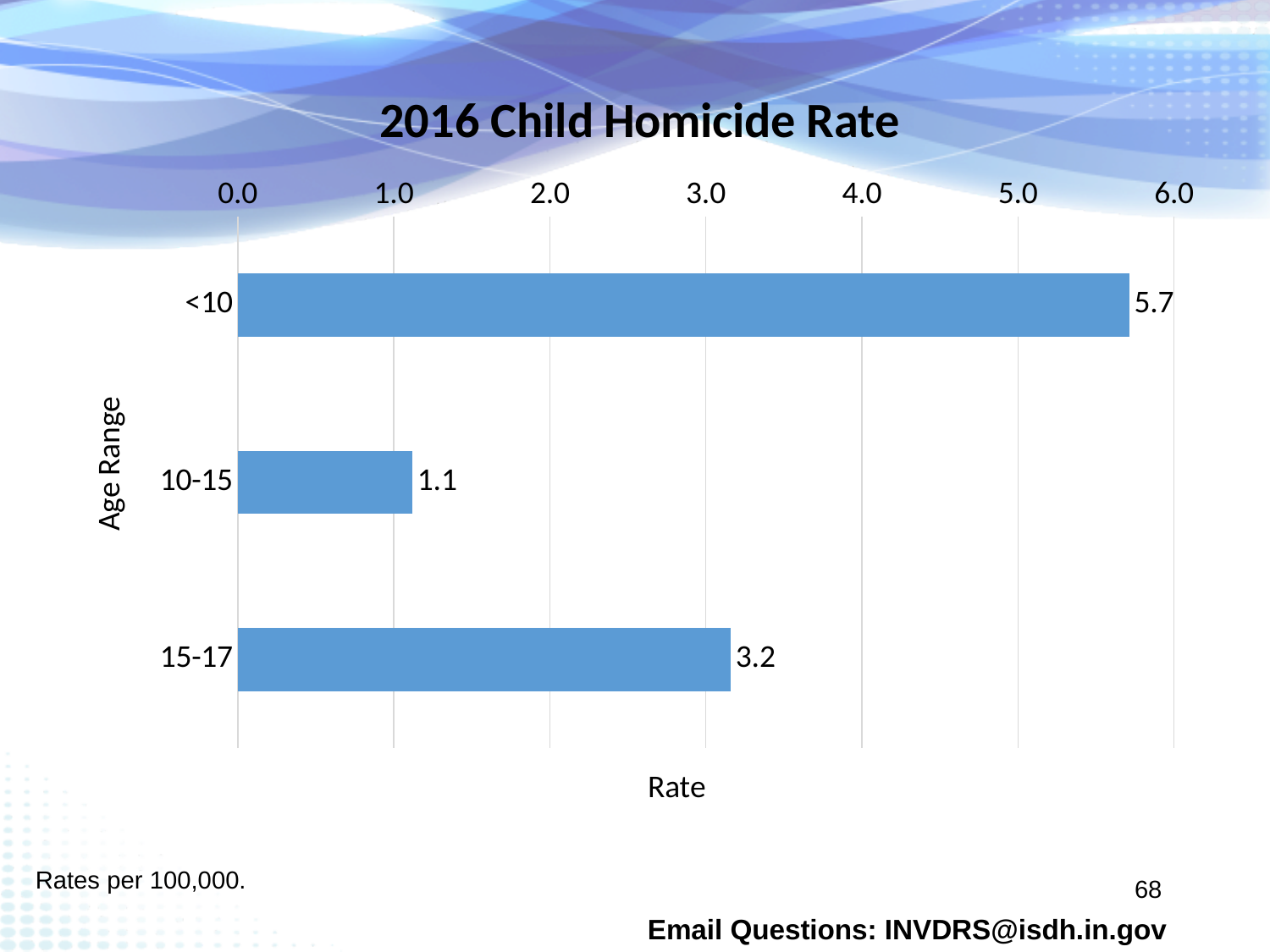
What is the title of the chart? 2016 Child Homicide Rate What is the difference between the rate for 15-17 and the rate for 10-15? 2.1 What is the 2016 child homicide rate for the <10 age range? 5.7 What kind of chart is shown on the slide? Bar chart How many age ranges are shown in the chart? 3 What is the difference between the rate for <10 and the rate for 15-17? 2.5 Which age range has the lowest child homicide rate? 10-15 Which age range has the highest child homicide rate? <10 What is the 2016 child homicide rate for the 10-15 age range? 1.1 What is the 2016 child homicide rate for the 15-17 age range? 3.2 Which has a higher child homicide rate, 10-15 or 15-17? 15-17 Is the value for <10 greater or less than 5.0? greater